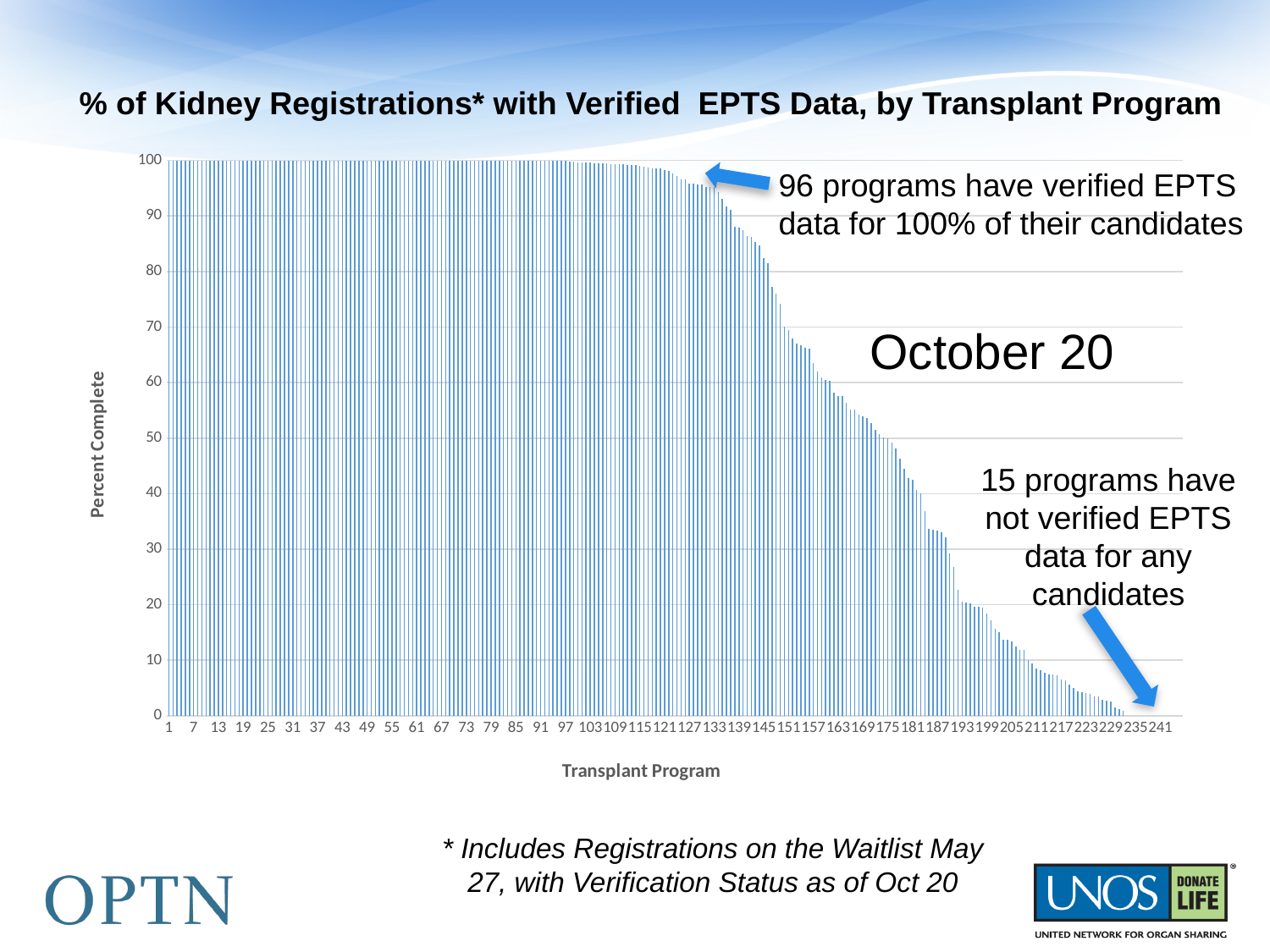
Is the value for transplant program 241 greater or less than 10? less What is the label on the vertical axis of the chart? Percent Complete Do the values rise or fall as you move from left to right along the x axis? fall Is the value for transplant program 229 greater or less than 20? less Is the value for transplant program 145 greater or less than 50? greater According to the annotation on the chart, how many programs have verified EPTS data for 100% of their candidates? 96 What is the title of the chart? % of Kidney Registrations* with Verified EPTS Data, by Transplant Program What kind of chart is shown on the slide? bar chart According to the annotation on the chart, how many programs have not verified EPTS data for any candidates? 15